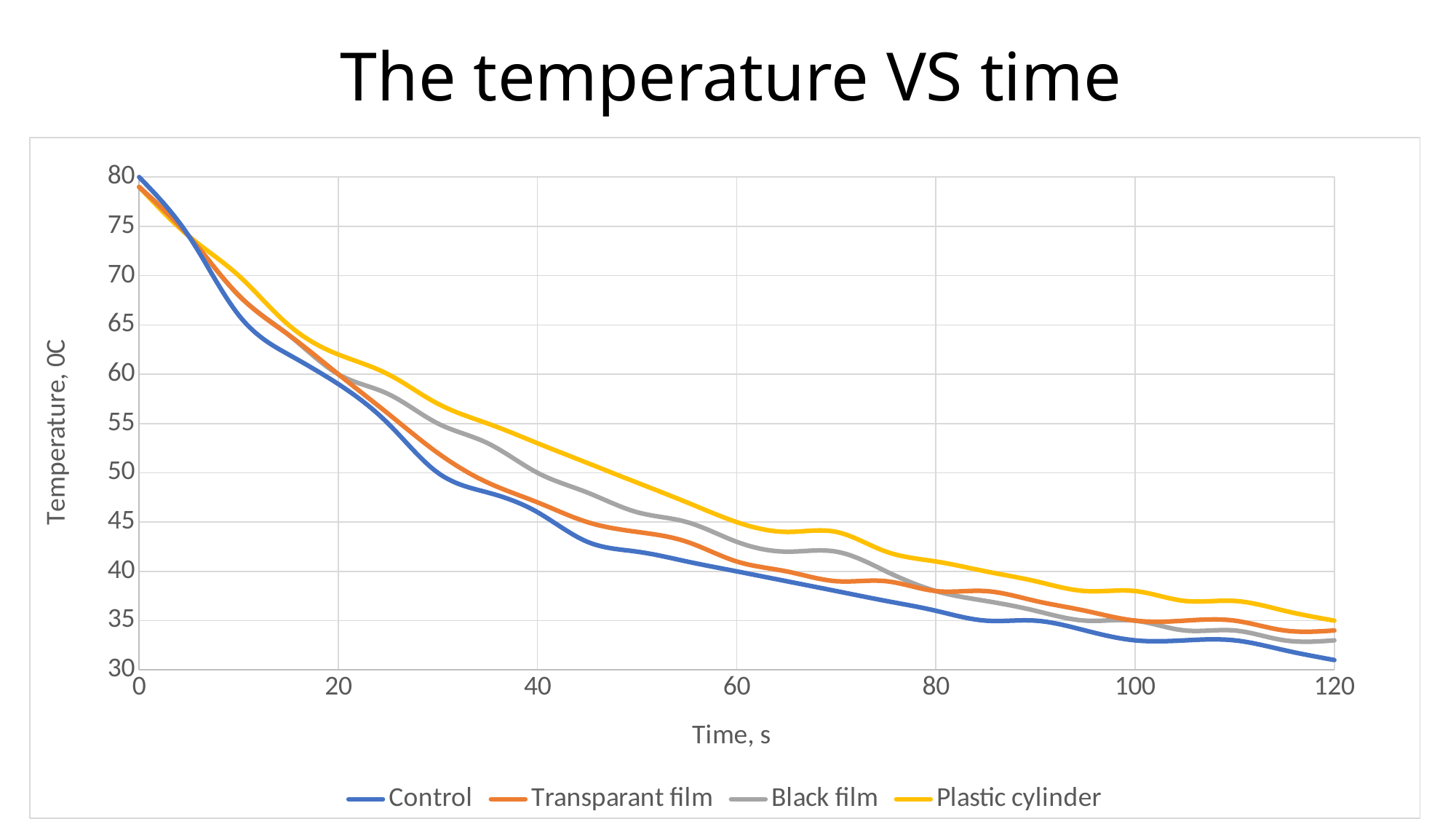
What is the title of the chart? The temperature VS time What is the label of the x axis? Time, s Which series has the lowest temperature at 120 s? Control How many series does the legend list? 4 Is the value for Transparant film at 80 s greater or less than 40? less Do the temperature values rise or fall as time increases? Fall Is the value for Plastic cylinder at 40 s greater or less than 50? greater At 40 s, which is higher: Black film or Transparant film? Black film At 60 s, which is higher: Plastic cylinder or Control? Plastic cylinder What kind of chart is shown on the slide? Line chart Which series has the highest temperature at 120 s? Plastic cylinder Is the value for Control at 120 s greater or less than 35? less